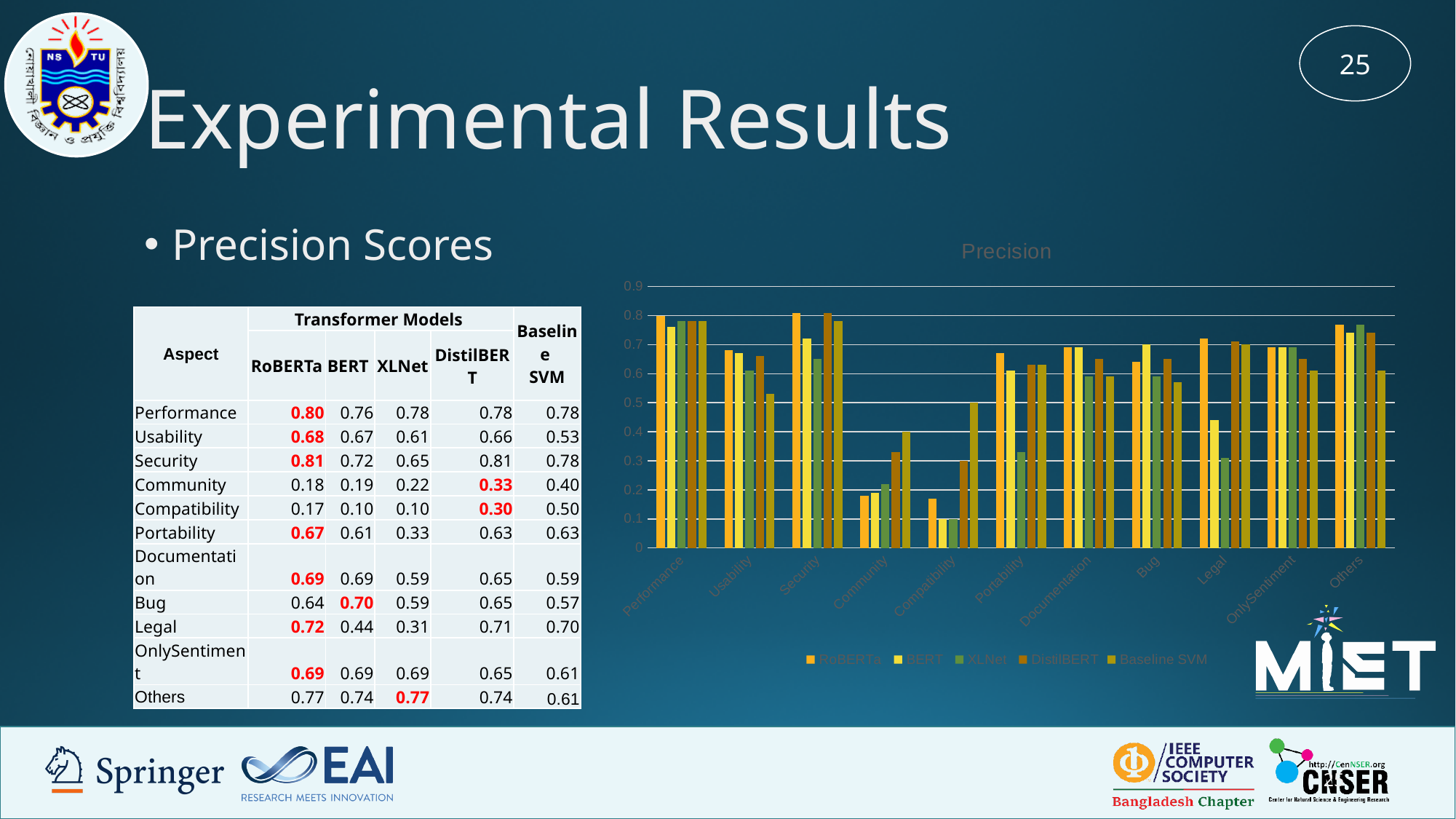
Is the Baseline SVM precision for the Usability aspect greater or less than 0.6? less Which series has the highest precision for the Community aspect? Baseline SVM What is the title of the chart? Precision What kind of chart is shown on the slide? bar chart How many series does the chart legend list? 5 What is the precision value for RoBERTa on the Security aspect? 0.81 What is the precision value for Baseline SVM on the Compatibility aspect? 0.50 Which series are listed in the chart legend? RoBERTa, BERT, XLNet, DistilBERT, Baseline SVM How many aspect categories are plotted along the x axis of the chart? 11 For the Legal aspect, which is larger: the RoBERTa precision or the BERT precision? RoBERTa What is the difference between the RoBERTa and BERT precision values for the Legal aspect? 0.28 Which aspect has the lowest precision for XLNet? Compatibility